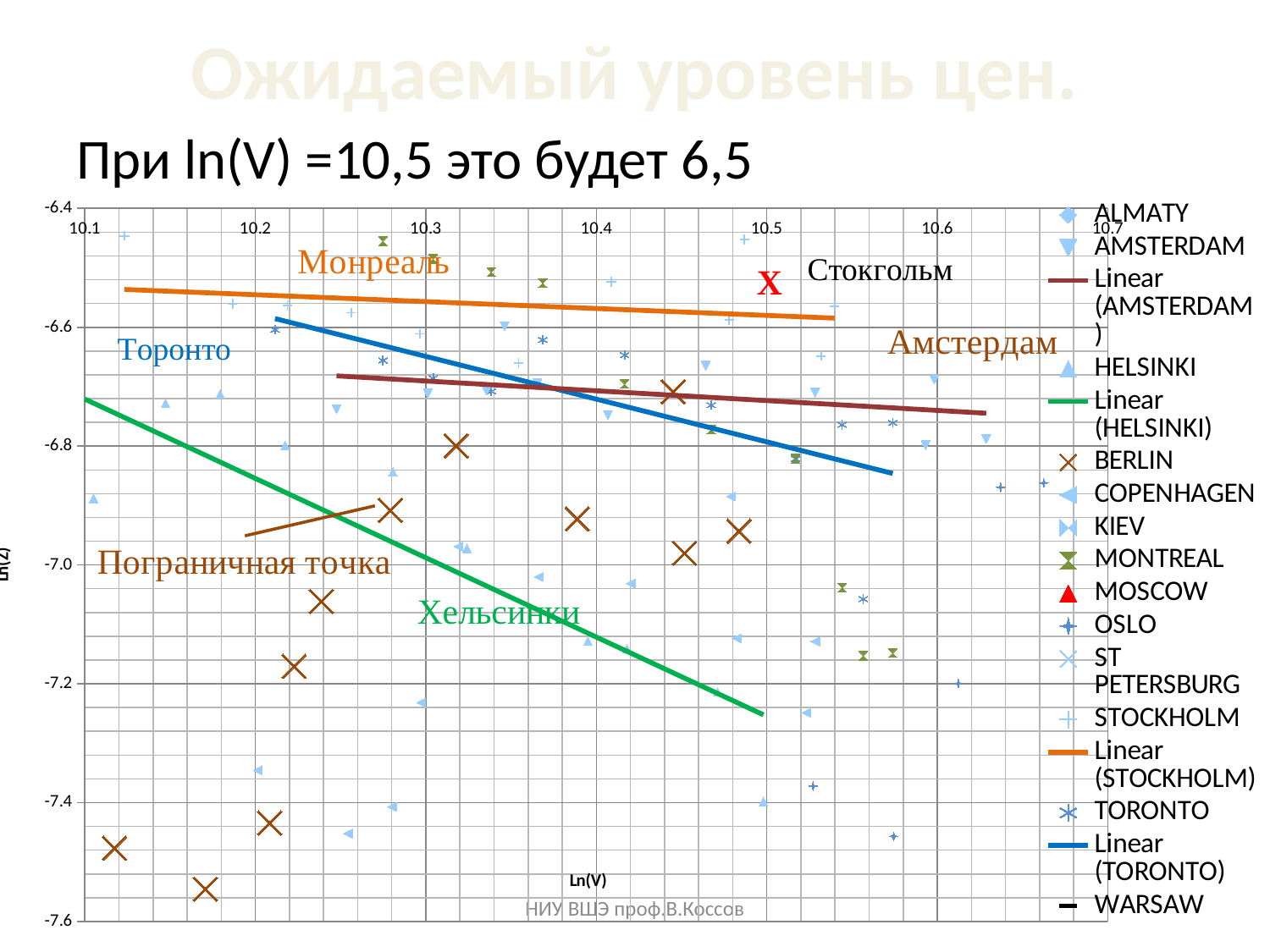
What is the lowest value shown on the y axis? -7.6 What kind of chart is shown on the slide? scatter chart Which trend line is higher at Ln(V) = 10.5, Linear (TORONTO) or Linear (HELSINKI)? Linear (TORONTO) Do the fitted trend lines rise or fall as Ln(V) increases? fall What is the label of the y axis? Ln(Z) What is the highest value shown on the x axis? 10.7 Which city's trend line lies lowest on the chart? Helsinki Is the value of the Linear (HELSINKI) trend line at Ln(V) = 10.5 greater or less than -7.0? less Which city's trend line lies highest on the chart? Stockholm Is the value of the Linear (STOCKHOLM) trend line at Ln(V) = 10.3 greater or less than -6.6? greater How many entries does the chart legend list? 17